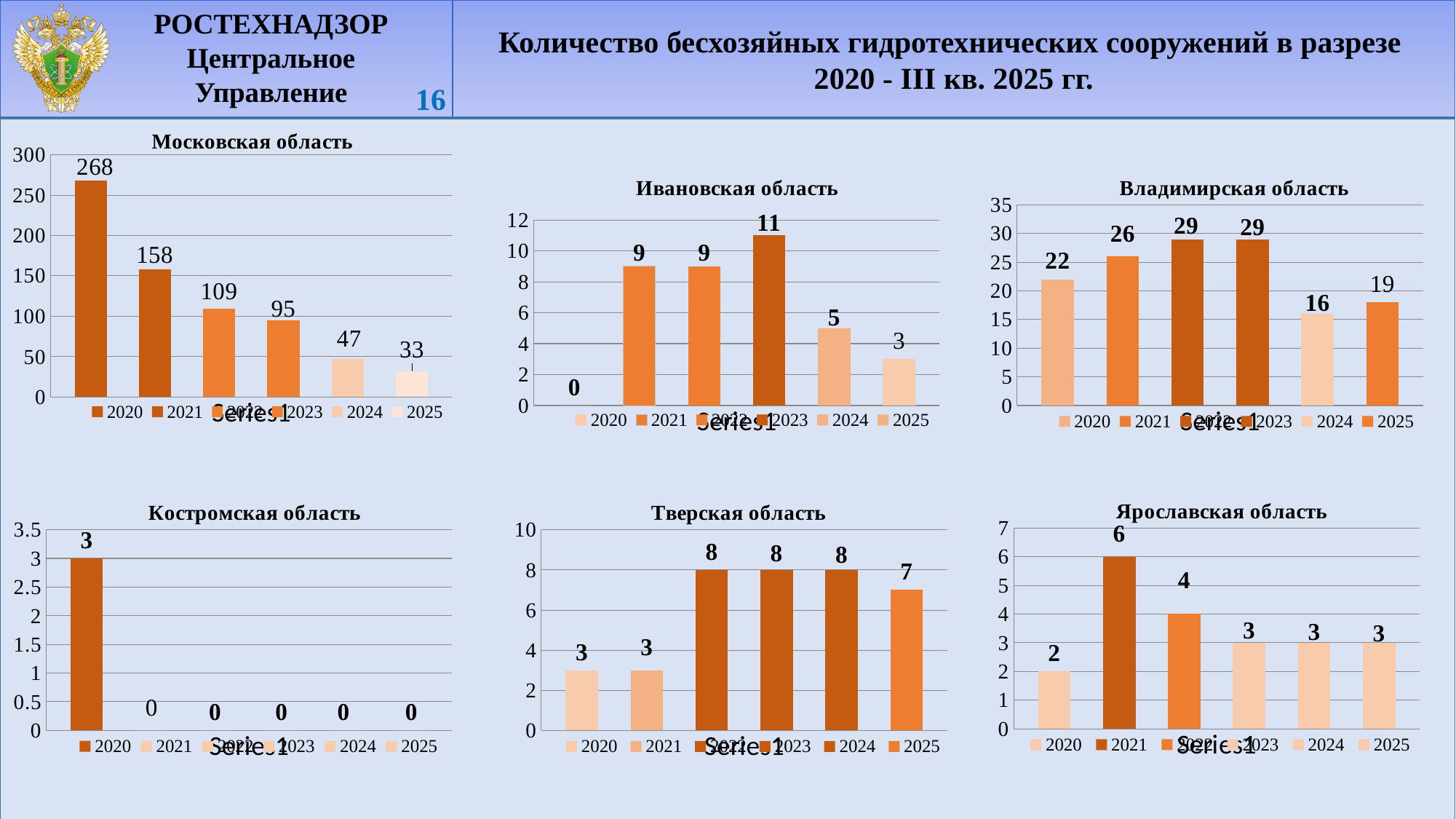
In the Владимирская область chart, which is larger, the value for 2021 or the value for 2025? 2021 In the Ивановская область chart, which year has the highest value? 2023 In the Тверская область chart, what is the value for 2025? 7 In the Московская область chart, do the values rise or fall from 2020 to 2025? fall In the Владимирская область chart, which year has the lowest value? 2024 In the Московская область chart, what is the difference between the 2021 and 2023 values? 63 In the Московская область chart, what is the value for 2020? 268 In the Ярославская область chart, what is the difference between the 2021 and 2020 values? 4 In the Ивановская область chart, what is the value for 2020? 0 How many charts are shown on the slide? 6 In the Костромская область chart, what is the value for 2020? 3 What type of chart is the Тверская область chart? bar chart